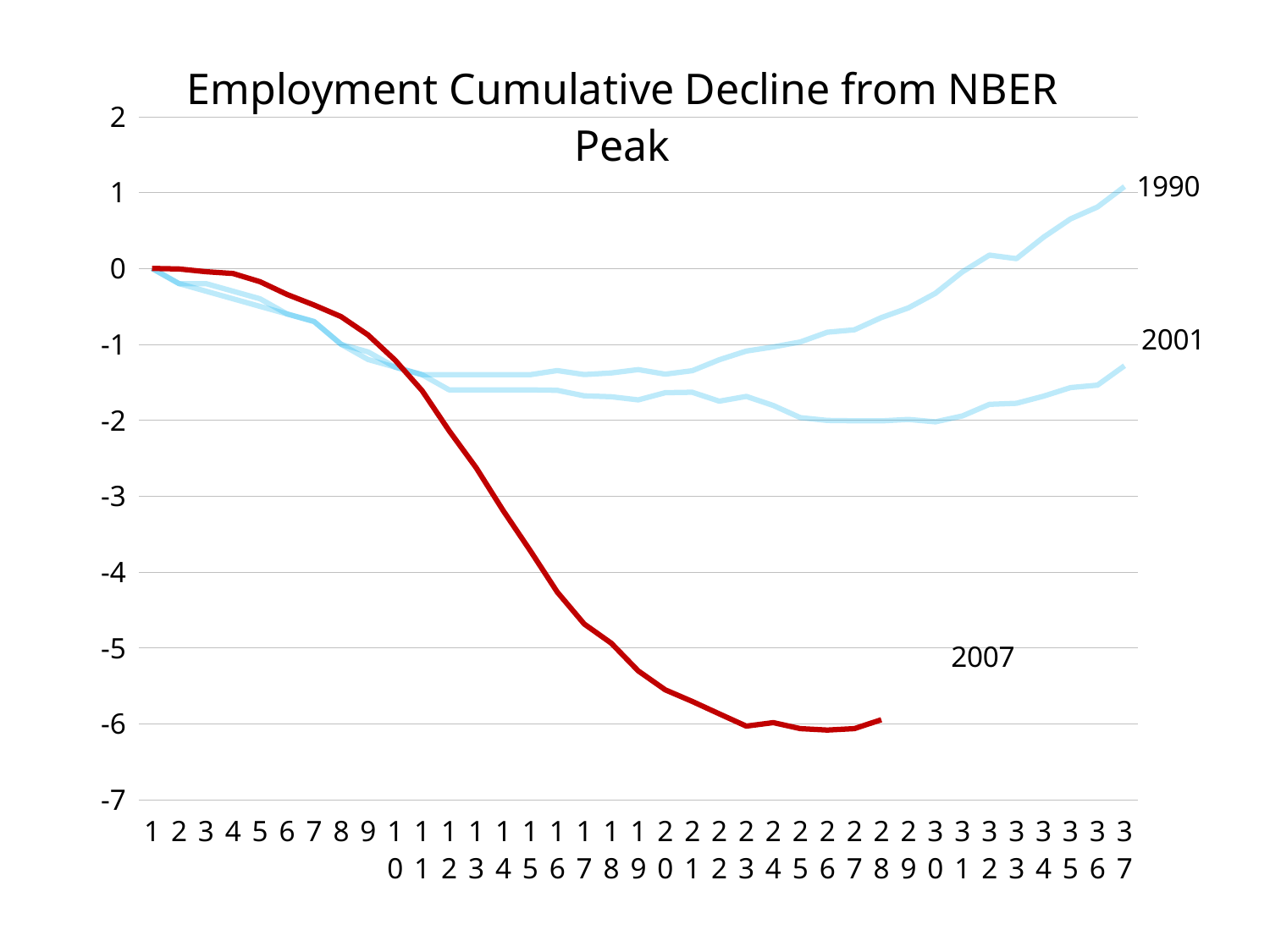
What is the title of the chart? Employment Cumulative Decline from NBER Peak Is the value of the 2001 line at point 37 greater or less than -1? less What kind of chart is shown on the slide? line chart Does the 1990 line rise or fall from point 20 to point 37? rise Which series reaches the lowest value on the chart? 2007 How many series (lines) are plotted on the chart? 3 Is the value of the 2007 line at point 28 greater or less than -5? less How many points are there along the x axis? 37 At point 37, which series has the higher value, 1990 or 2001? 1990 Does the 2007 line rise or fall from point 1 to point 23? fall Which series reaches the highest value on the chart? 1990 Is the value of the 1990 line at point 37 greater or less than 0? greater